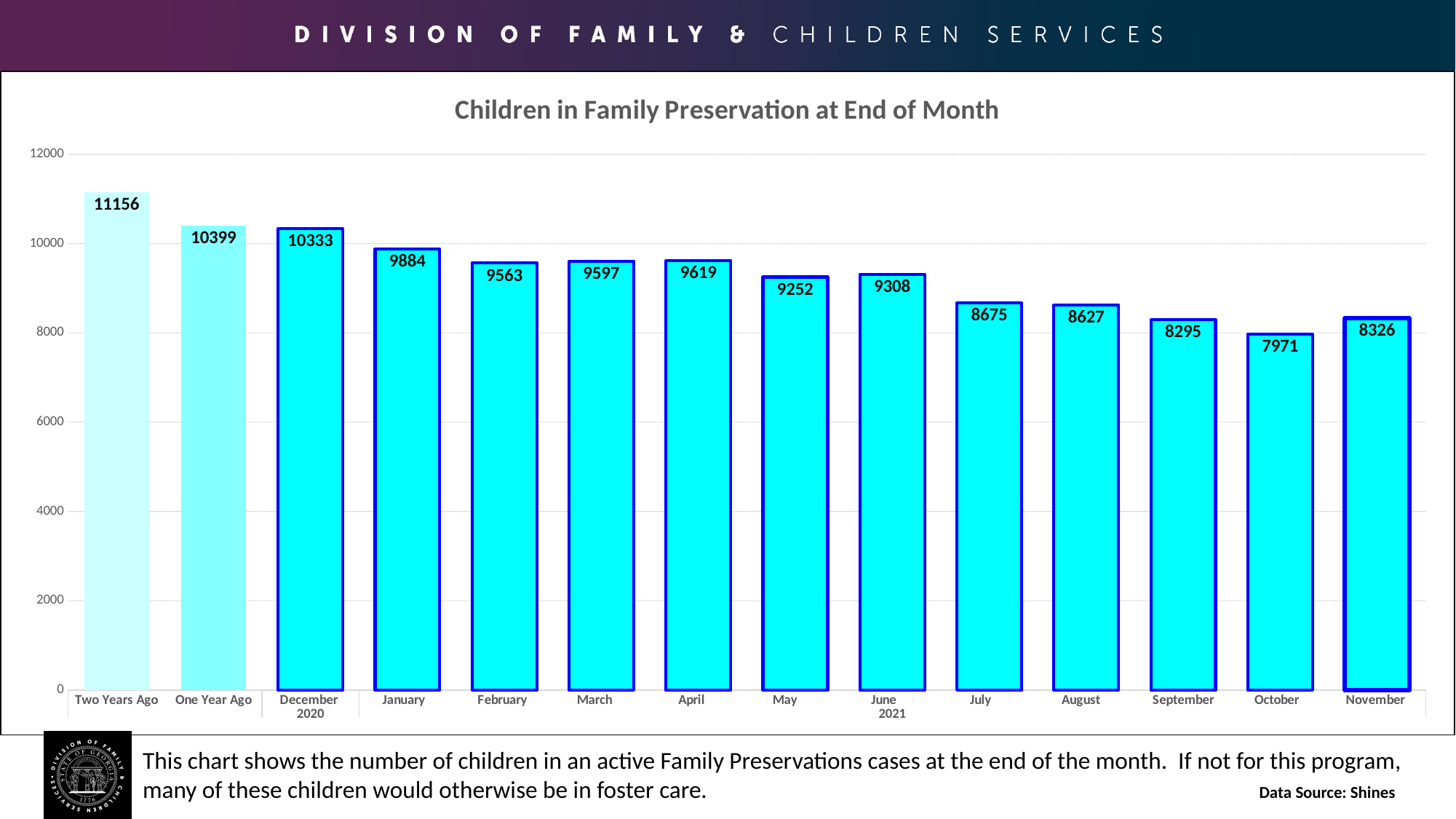
Which category has the highest value? Two Years Ago What is the title of the chart? Children in Family Preservation at End of Month What is the value for December 2020? 10333 What kind of chart is this? bar chart How many bars are shown in the chart? 14 Which is larger, the value for April or the value for May? April What is the difference between the values for One Year Ago and November? 2073 Which category has the lowest value? October What is the value for October? 7971 Is the value for July greater or less than 8000? greater Do the values generally rise or fall from December 2020 to October? fall What is the value for Two Years Ago? 11156